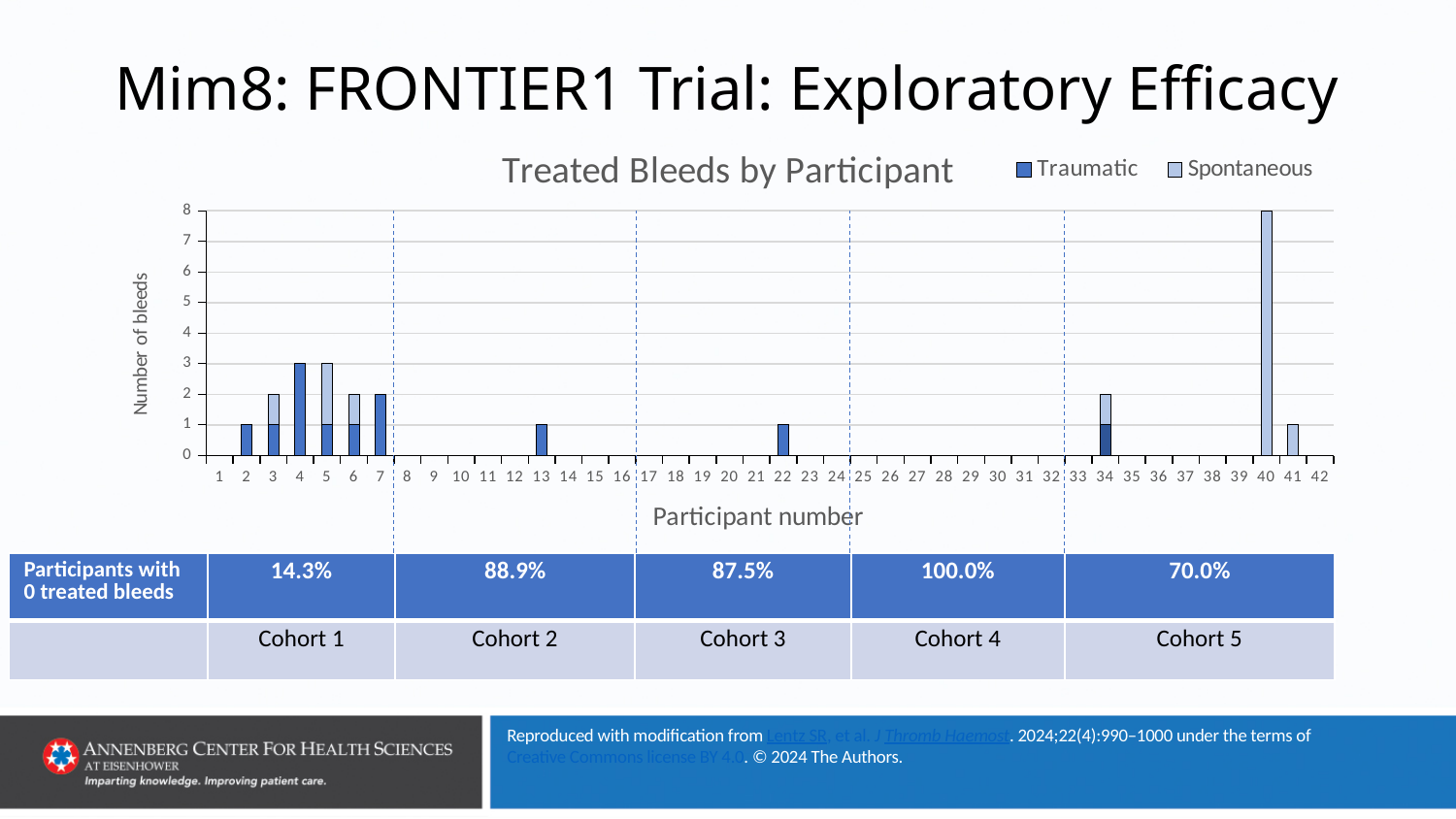
How many treated bleeds are shown for participant 40? 8 What is the title of the chart? Treated Bleeds by Participant What type of chart is shown on the slide? Bar chart Which has more treated bleeds, participant 7 or participant 13? Participant 7 What is the total number of treated bleeds for participant 5? 3 How many series does the chart legend list? 2 Which participant number has the highest total number of treated bleeds? 40 How many participant numbers are shown on the x axis? 42 What is the difference in treated bleeds between participant 40 and participant 41? 7 How many treated bleeds are shown for participant 4? 3 What is the label of the y axis? Number of bleeds Is the value for participant 40 greater or less than 4? greater